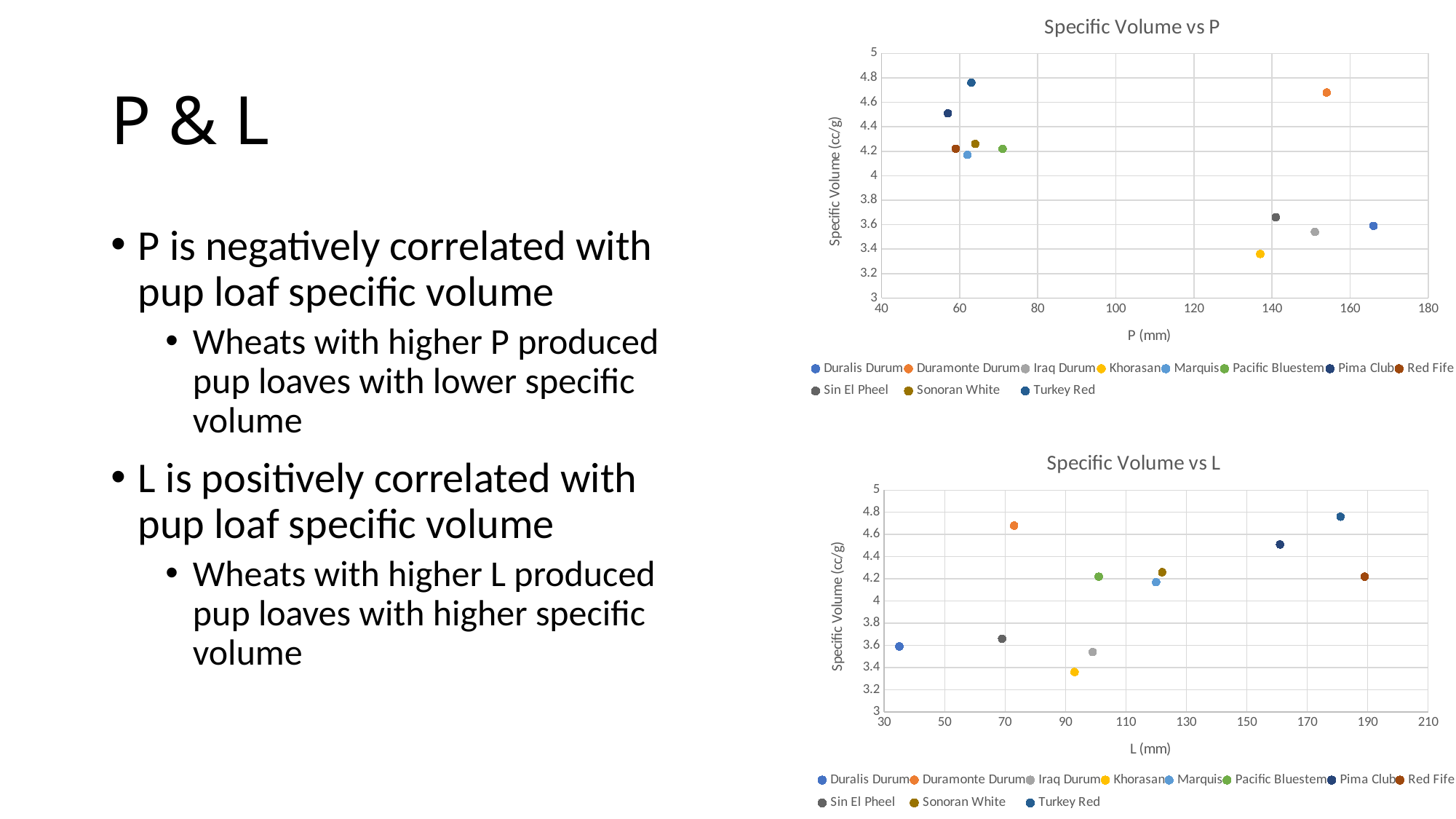
What is the y-axis label of the bottom chart? Specific Volume (cc/g) In "Specific Volume vs P", do specific volumes generally rise or fall as P increases? fall In "Specific Volume vs L", do specific volumes generally rise or fall as L increases? rise In "Specific Volume vs P", is the specific volume for Khorasan greater or less than 3.6? less In "Specific Volume vs P", is the specific volume for Turkey Red greater or less than 4.6? greater How many data points are plotted in "Specific Volume vs P"? 11 How many series does the legend of "Specific Volume vs L" list? 11 In "Specific Volume vs L", is the L value for Red Fife greater or less than 170? greater In "Specific Volume vs L", which has the higher specific volume, Turkey Red or Khorasan? Turkey Red In "Specific Volume vs P", which wheat has the lowest specific volume? Khorasan What kind of chart is "Specific Volume vs P"? scatter chart